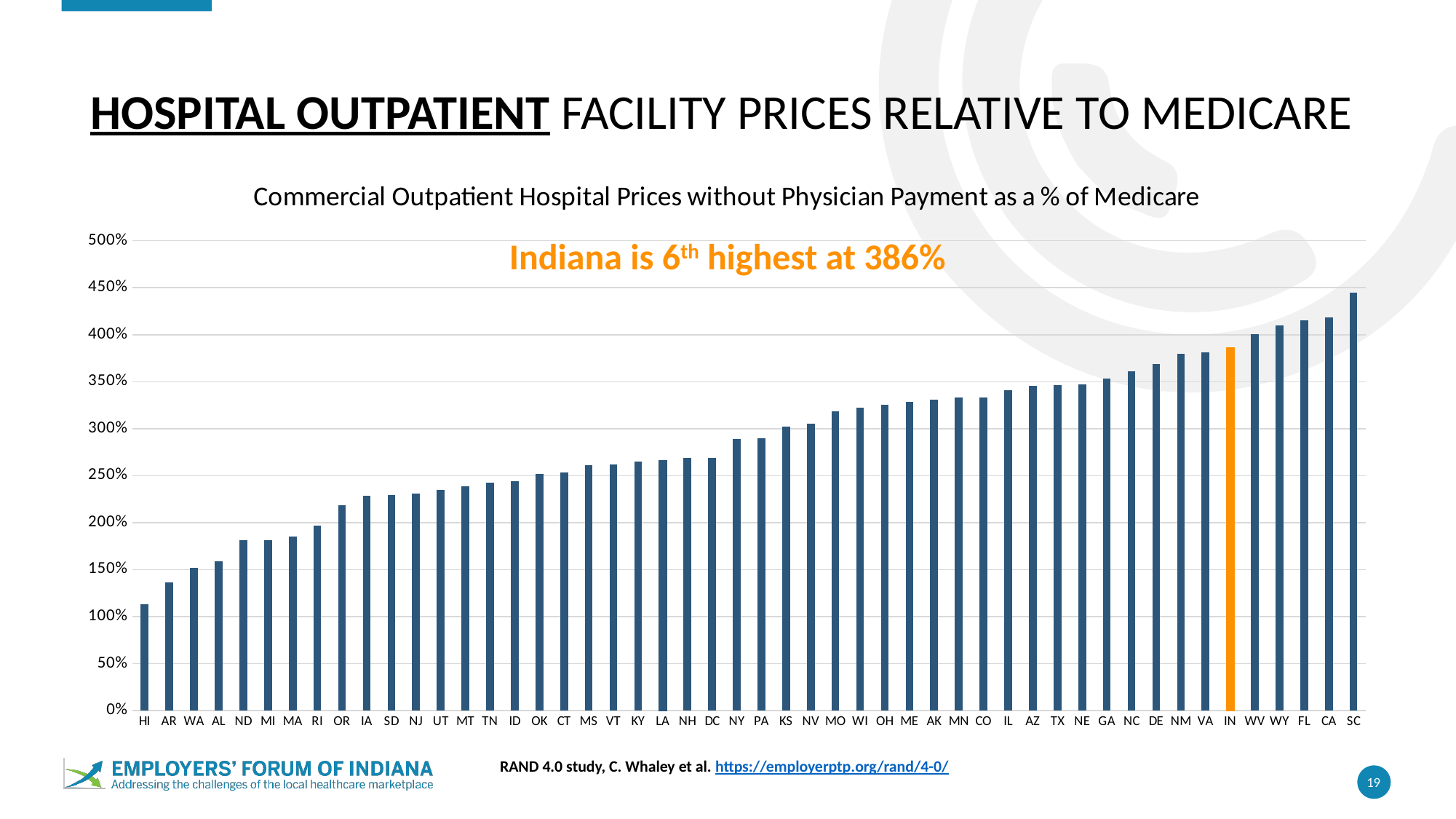
According to the annotation, what rank does Indiana hold among the states? 6th highest Which state's bar is highlighted in orange? IN Which state has the lowest value in the chart? HI How many states (categories) are plotted in the chart? 50 Is the value for SC greater or less than 400%? greater What kind of chart is shown on the slide? Bar chart Which state has the highest value in the chart? SC Do the values rise or fall moving from left to right along the x axis? Rise Is the value for HI greater or less than 150%? less What is the value for IN (Indiana) in the chart? 386% Which has the larger value, CA or AR? CA Is the value for NY greater or less than 300%? less